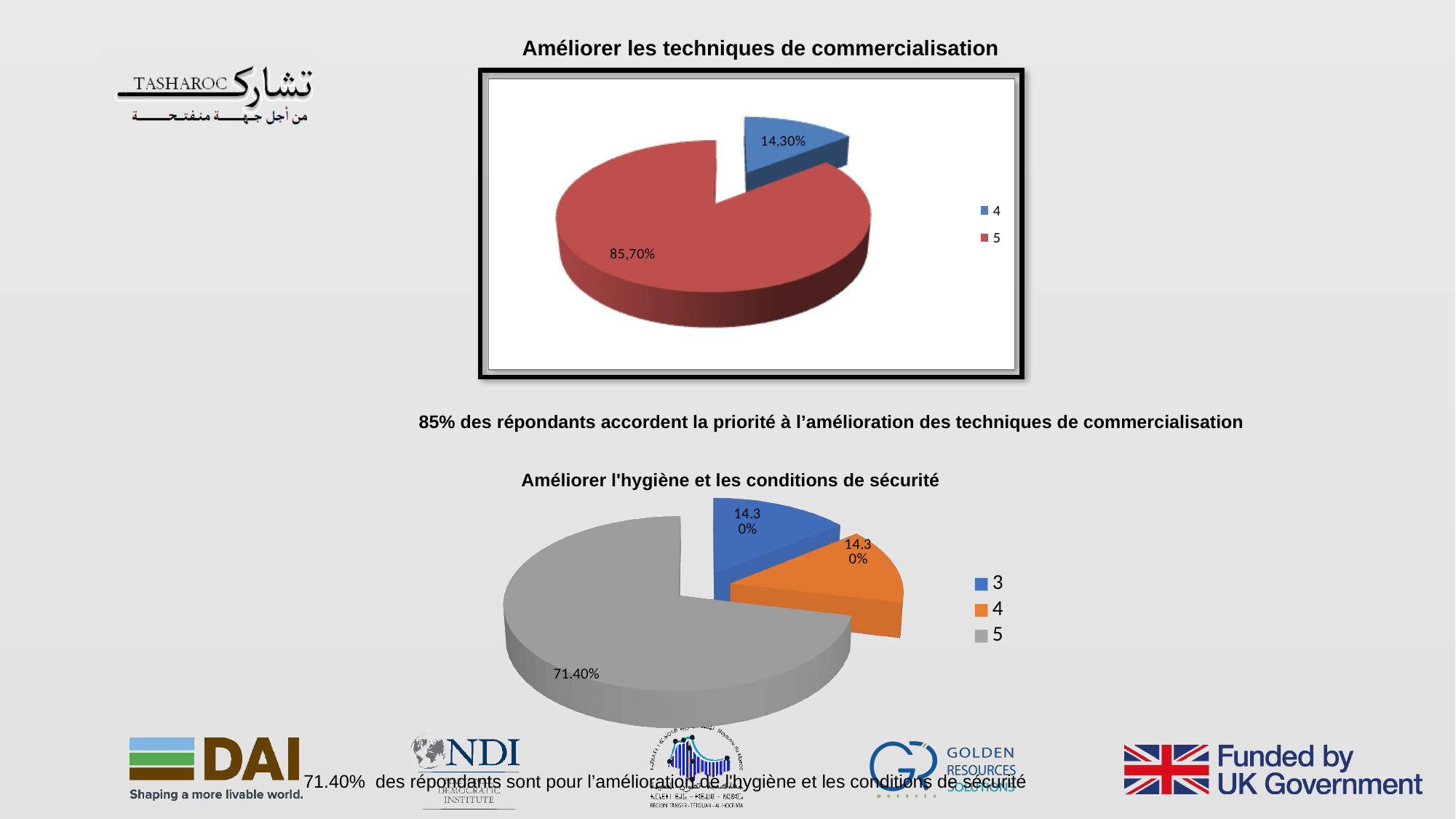
In the chart titled "Améliorer l'hygiène et les conditions de sécurité", what percentage is shown for category 5? 71.40% In the chart titled "Améliorer les techniques de commercialisation", how many categories does the legend list? 2 In the chart titled "Améliorer l'hygiène et les conditions de sécurité", which category has the largest slice? 5 In the chart titled "Améliorer l'hygiène et les conditions de sécurité", how many slices does the pie have? 3 In the chart titled "Améliorer l'hygiène et les conditions de sécurité", what percentage is shown for category 3? 14.30% In the chart titled "Améliorer les techniques de commercialisation", what is the difference between the slices for category 5 and category 4? 71,40% In the chart titled "Améliorer l'hygiène et les conditions de sécurité", what colour is the slice for category 4? Orange In the chart titled "Améliorer les techniques de commercialisation", what percentage is shown for category 5? 85,70% What kind of chart is the top chart on the slide? Pie chart In the chart titled "Améliorer l'hygiène et les conditions de sécurité", which is larger, the slice for category 5 or the slice for category 4? 5 In the chart titled "Améliorer les techniques de commercialisation", which category has the largest slice? 5 In the chart titled "Améliorer les techniques de commercialisation", what percentage is shown for category 4? 14,30%